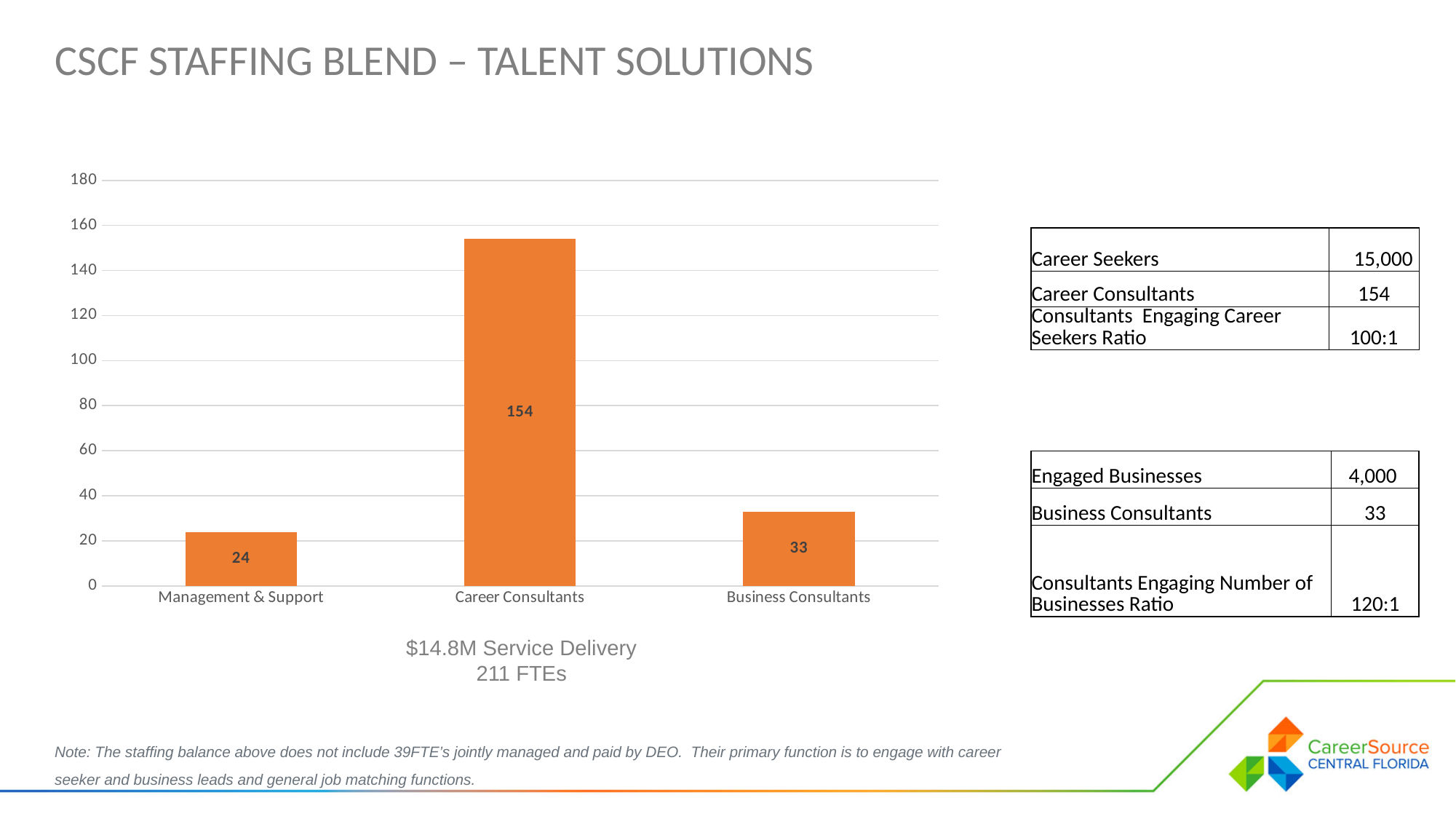
What is the difference between the values for Business Consultants and Management & Support? 9 What kind of chart is shown on the slide? bar chart Is the value for Career Consultants greater or less than 140? greater Which category has the lowest value? Management & Support What is the value for Business Consultants? 33 What is the difference between the values for Career Consultants and Business Consultants? 121 Which category has the highest value? Career Consultants What is the value for Career Consultants? 154 Which is larger, the value for Business Consultants or the value for Management & Support? Business Consultants What is the value for Management & Support? 24 What colour are the bars in the chart? orange How many categories are shown on the chart? 3